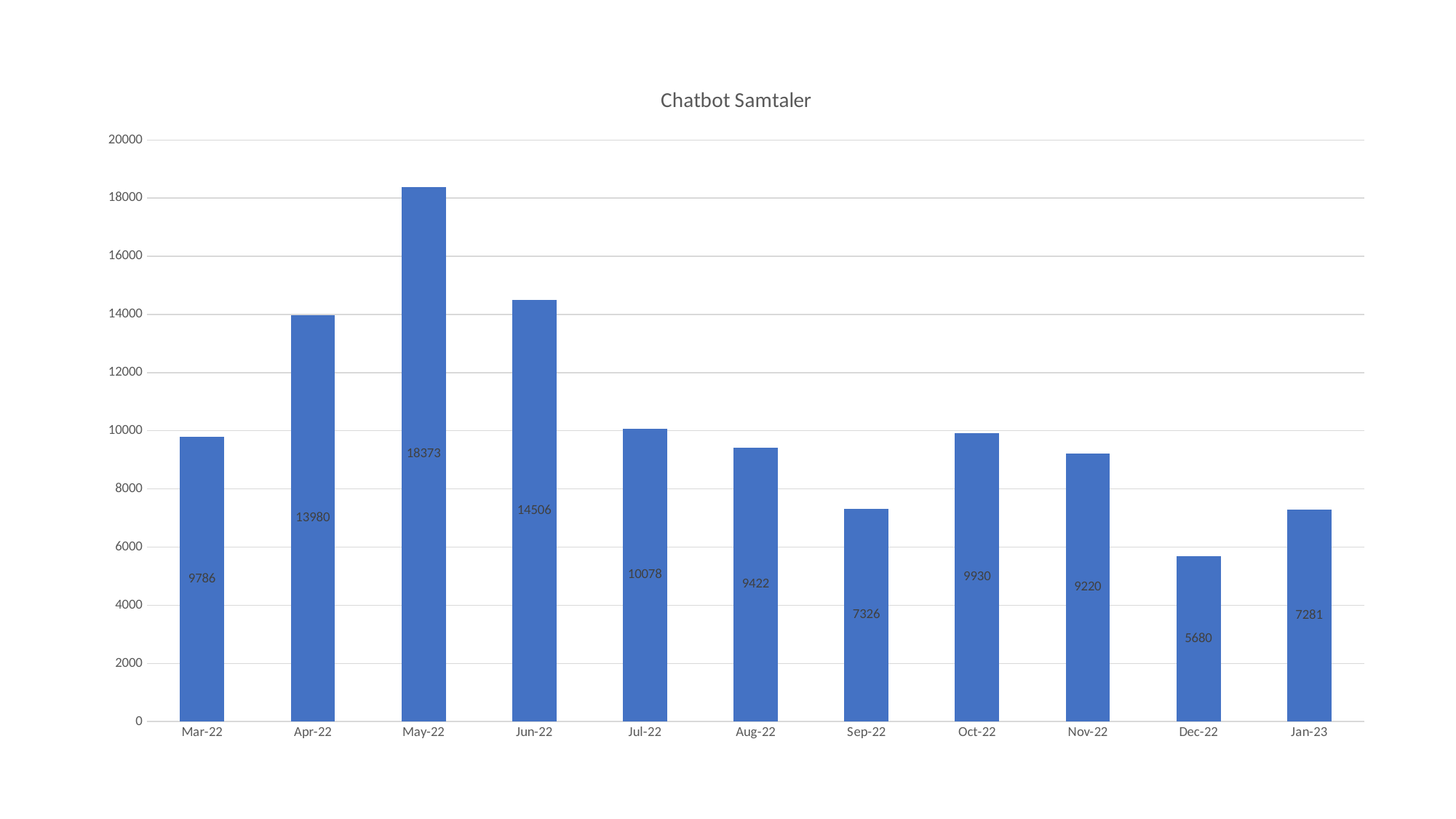
Which month has the lowest value? Dec-22 What is the value for Dec-22? 5680 What is the difference between the values for Apr-22 and Mar-22? 4194 What is the difference between the values for May-22 and Jun-22? 3867 How many months are shown on the x axis? 11 What is the value for May-22? 18373 Which is larger, the value for Oct-22 or the value for Nov-22? Oct-22 What kind of chart is shown? bar chart What is the title of the chart? Chatbot Samtaler What is the value for Sep-22? 7326 Is the value for Jun-22 greater or less than 14000? greater Which month has the highest value? May-22